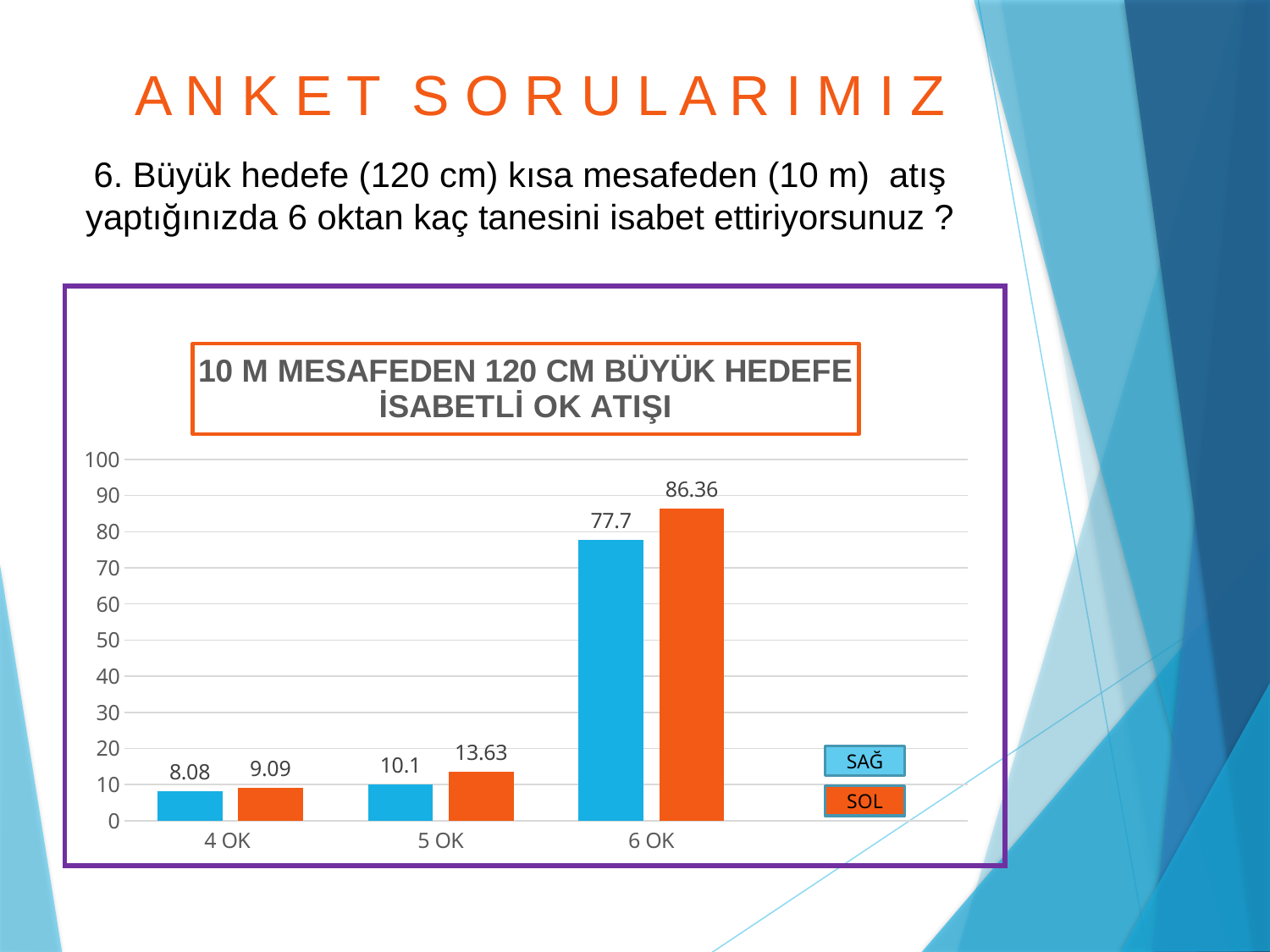
What is the difference between the SOL and SAĞ values at 6 OK? 8.66 How many series does the legend list? 2 What colour are the SOL bars? orange Which category has the lowest value for SAĞ? 4 OK What is the value for SAĞ at 4 OK? 8.08 Which is larger at 5 OK, SAĞ or SOL? SOL What is the value for SAĞ at 6 OK? 77.7 How many categories are shown on the x axis? 3 Is the value for SOL at 6 OK greater or less than 80? greater What kind of chart is shown? bar chart What is the value for SOL at 5 OK? 13.63 Which category has the highest value for SOL? 6 OK